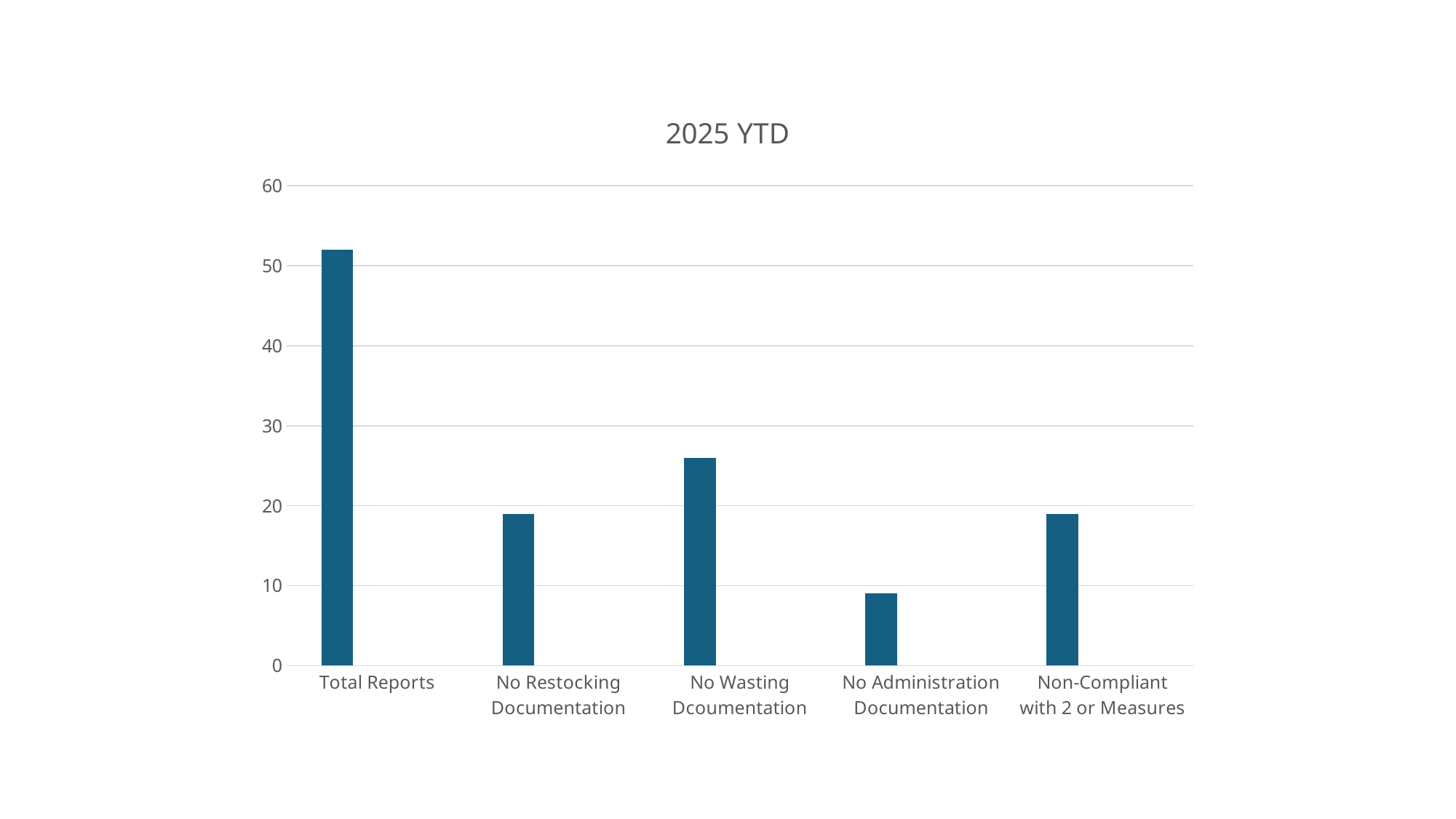
Which is larger, the value for Total Reports or the value for No Wasting Dcoumentation? Total Reports Is the value for Total Reports greater or less than 40? greater Is the value for No Administration Documentation greater or less than 10? less Is the value for No Restocking Documentation greater or less than 10? greater How many categories are shown on the x axis? 5 Which category has the lowest value? No Administration Documentation Which is larger, the value for No Wasting Dcoumentation or the value for No Administration Documentation? No Wasting Dcoumentation Which category has the highest value? Total Reports What type of chart is shown on the slide? bar chart What is the title of the chart? 2025 YTD